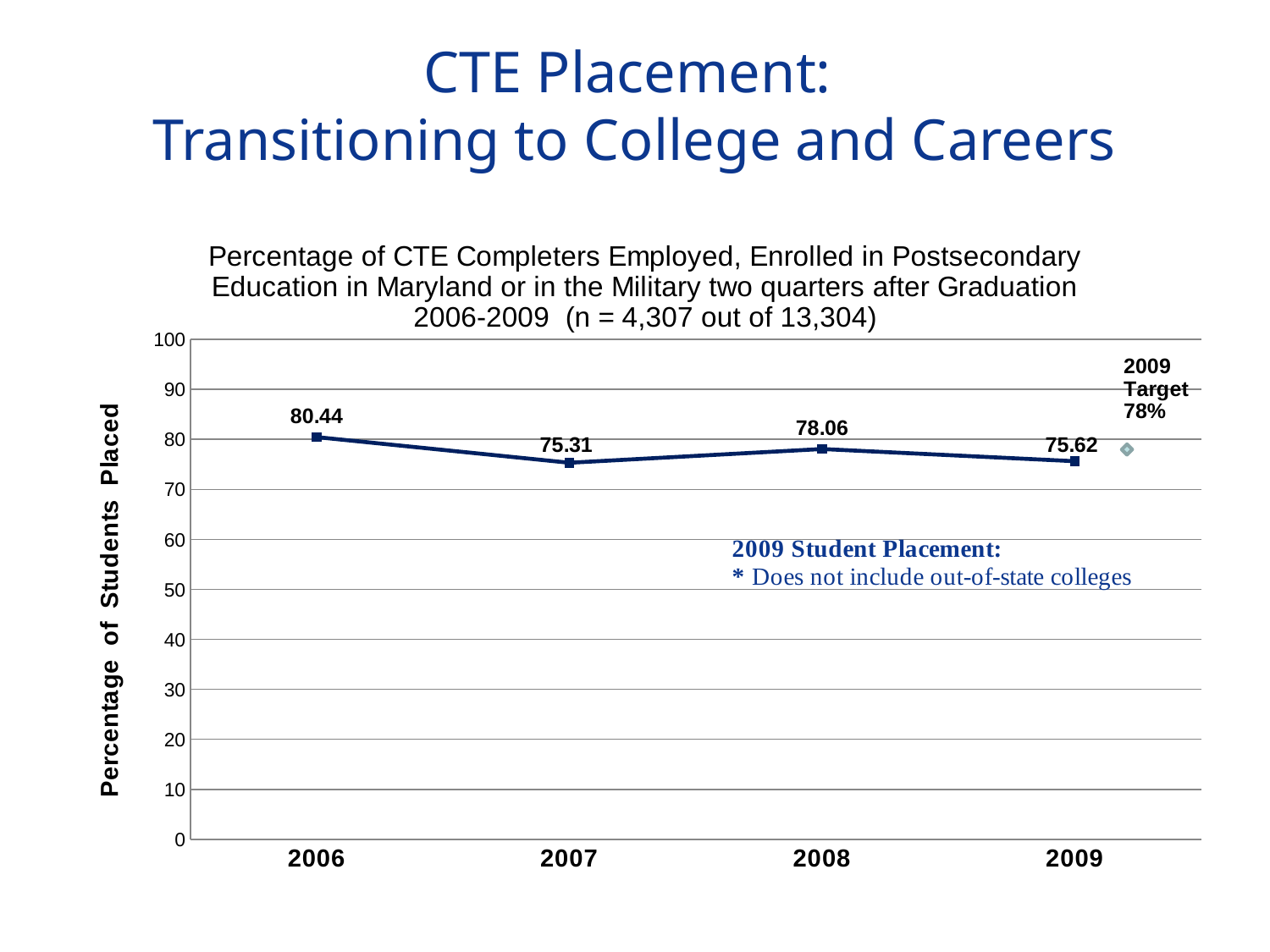
What is the value for 2006? 80.44 What kind of chart is shown? line chart Which year has the lowest value? 2007 Is the value for 2007 greater or less than 80? less What is the difference between the values for 2006 and 2007? 5.13 Which is larger, the value for 2008 or the value for 2009? 2008 What is the value for 2009? 75.62 How many years are plotted on the chart? 4 What is the 2009 target shown on the chart? 78% What is the value for 2007? 75.31 Which year has the highest value? 2006 What is the value for 2008? 78.06